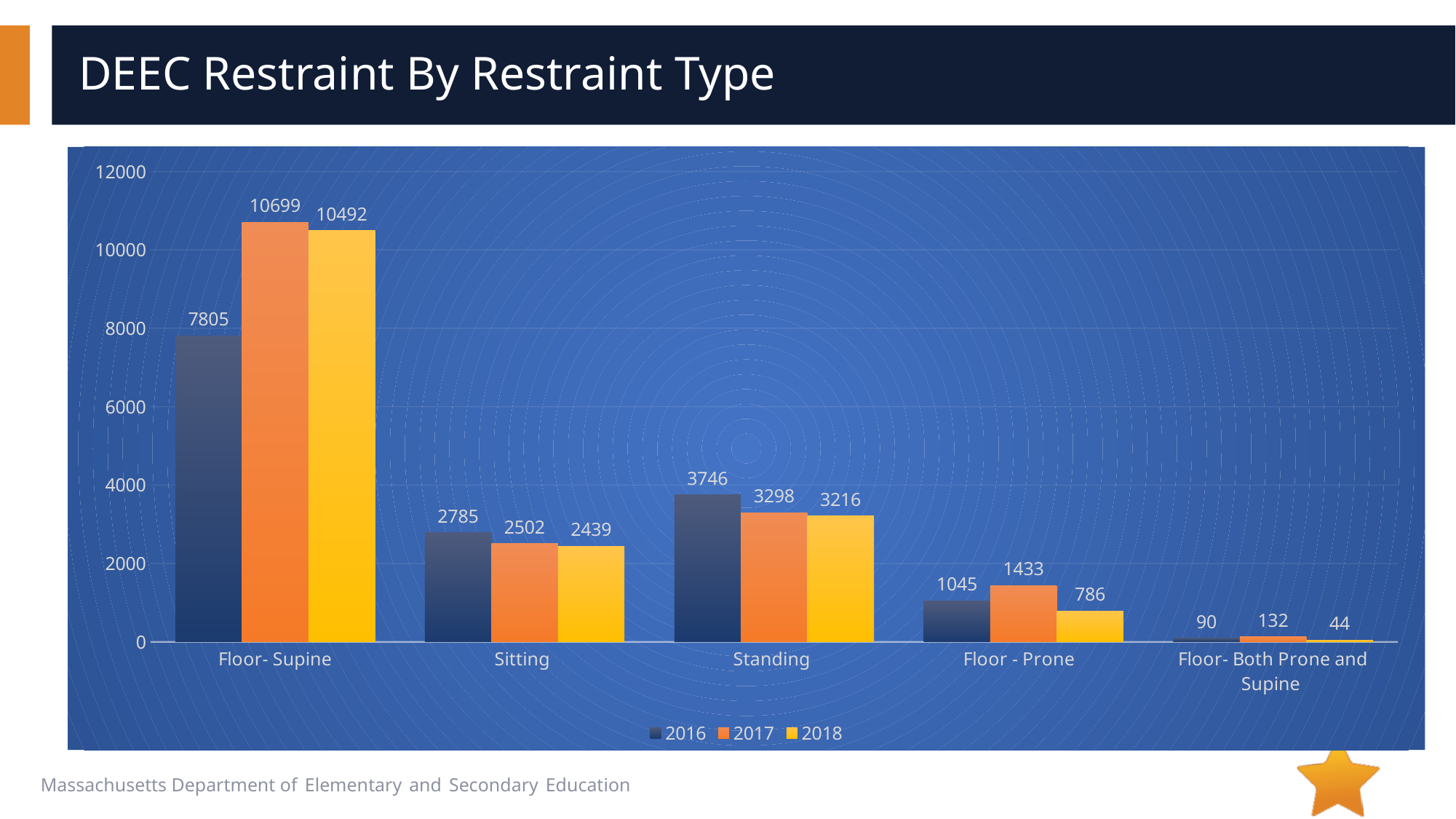
Which restraint type has the lowest value in 2016? Floor- Both Prone and Supine What is the value for Floor- Supine in 2017? 10699 How many series does the legend list? 3 What is the value for Standing in 2016? 3746 What is the title of the chart on the slide? DEEC Restraint By Restraint Type What is the difference between the 2017 and 2016 values for Floor- Supine? 2894 What is the value for Floor - Prone in 2018? 786 What is the difference between the 2016 and 2018 values for Sitting? 346 Which is larger for Floor - Prone: the 2017 value or the 2016 value? 2017 What kind of chart is shown on the slide? Bar chart How many restraint type categories are shown on the x axis? 5 Which restraint type has the highest value in 2018? Floor- Supine